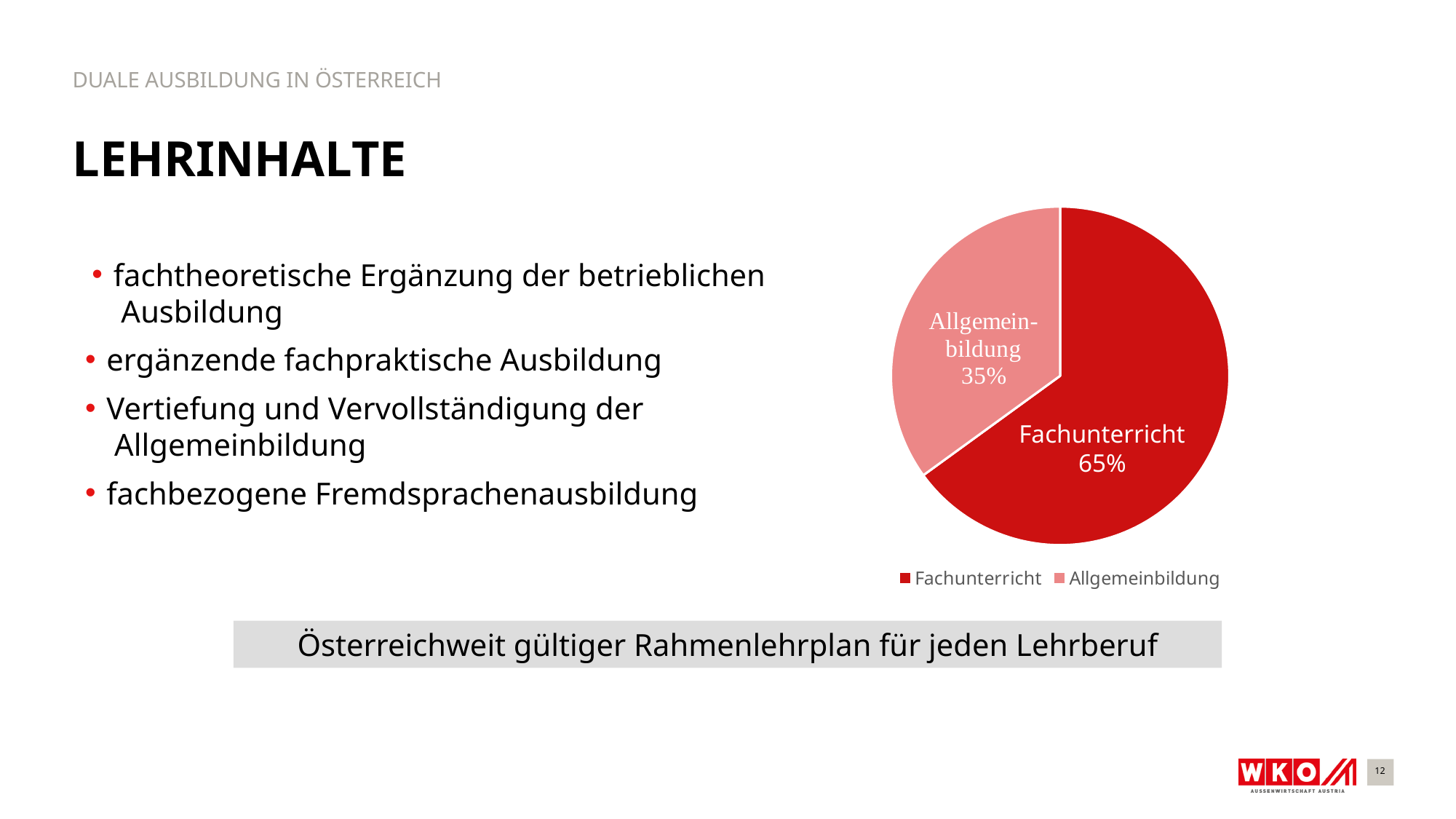
What is the difference in percentage points between Fachunterricht and Allgemeinbildung? 30 How many slices does the pie chart have? 2 Which slice of the pie chart is the largest? Fachunterricht What kind of chart is shown on the slide? pie chart How many entries does the legend list? 2 Which is larger, Fachunterricht or Allgemeinbildung? Fachunterricht What share of the pie does Fachunterricht have? 65% Which legend entry is listed first? Fachunterricht What share of the pie does Allgemeinbildung have? 35% What colour is the Allgemeinbildung slice? light red (pink) Which slice of the pie chart is the smallest? Allgemeinbildung